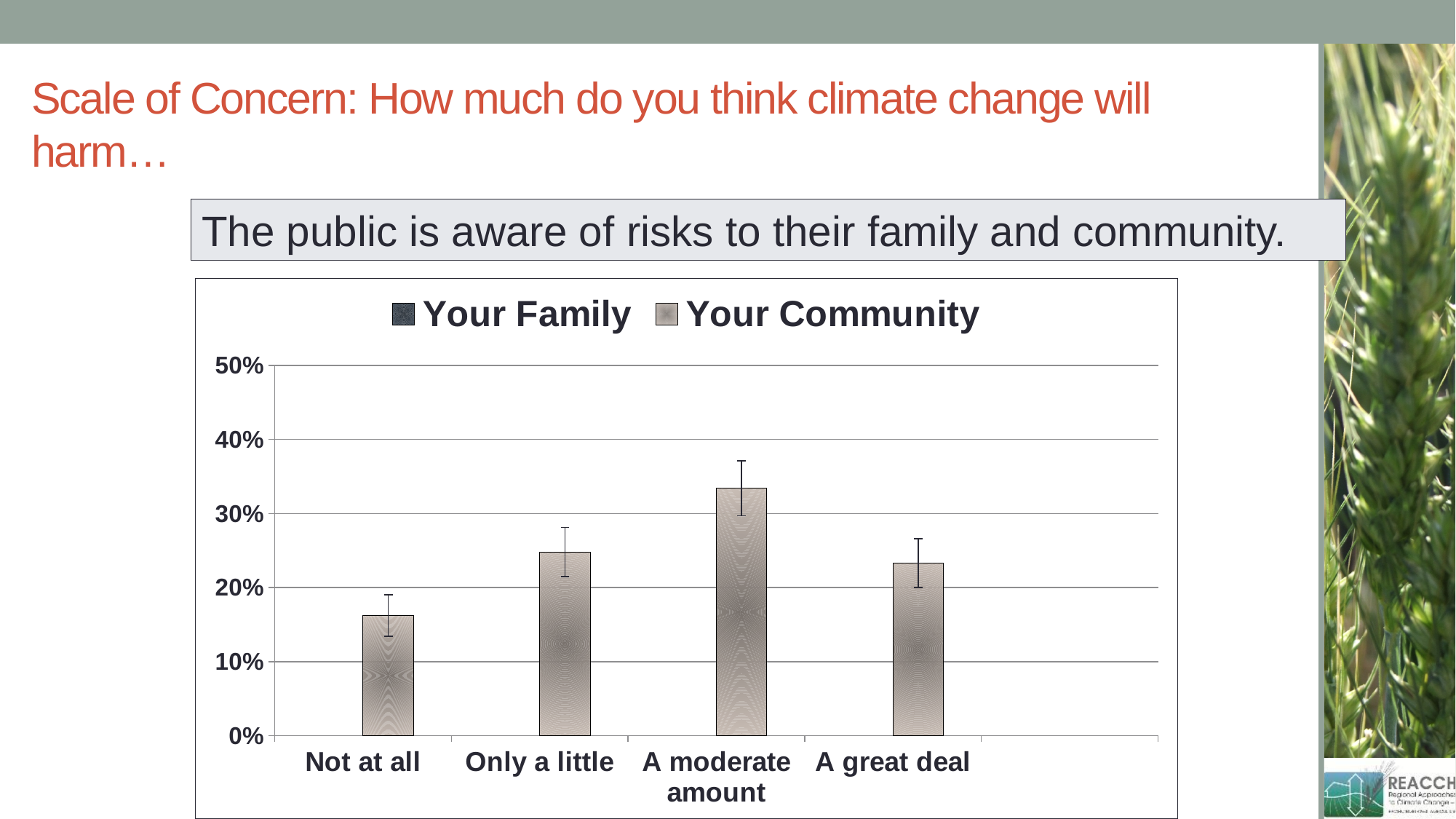
Is the value for 'Only a little' greater or less than 20%? greater Is the value for 'Not at all' greater or less than 20%? less Which category has the highest bar in the chart? A moderate amount Which is larger, the bar for 'Not at all' or the bar for 'A great deal'? A great deal Is the value for 'A moderate amount' greater or less than 30%? greater Which category has the lowest bar in the chart? Not at all What are the two series names listed in the chart's legend? Your Family, Your Community Do the bar values rise or fall from 'Not at all' to 'A moderate amount'? rise What kind of chart is shown on the slide? bar chart How many categories are shown on the x axis of the chart? 4 How many series does the chart's legend list? 2